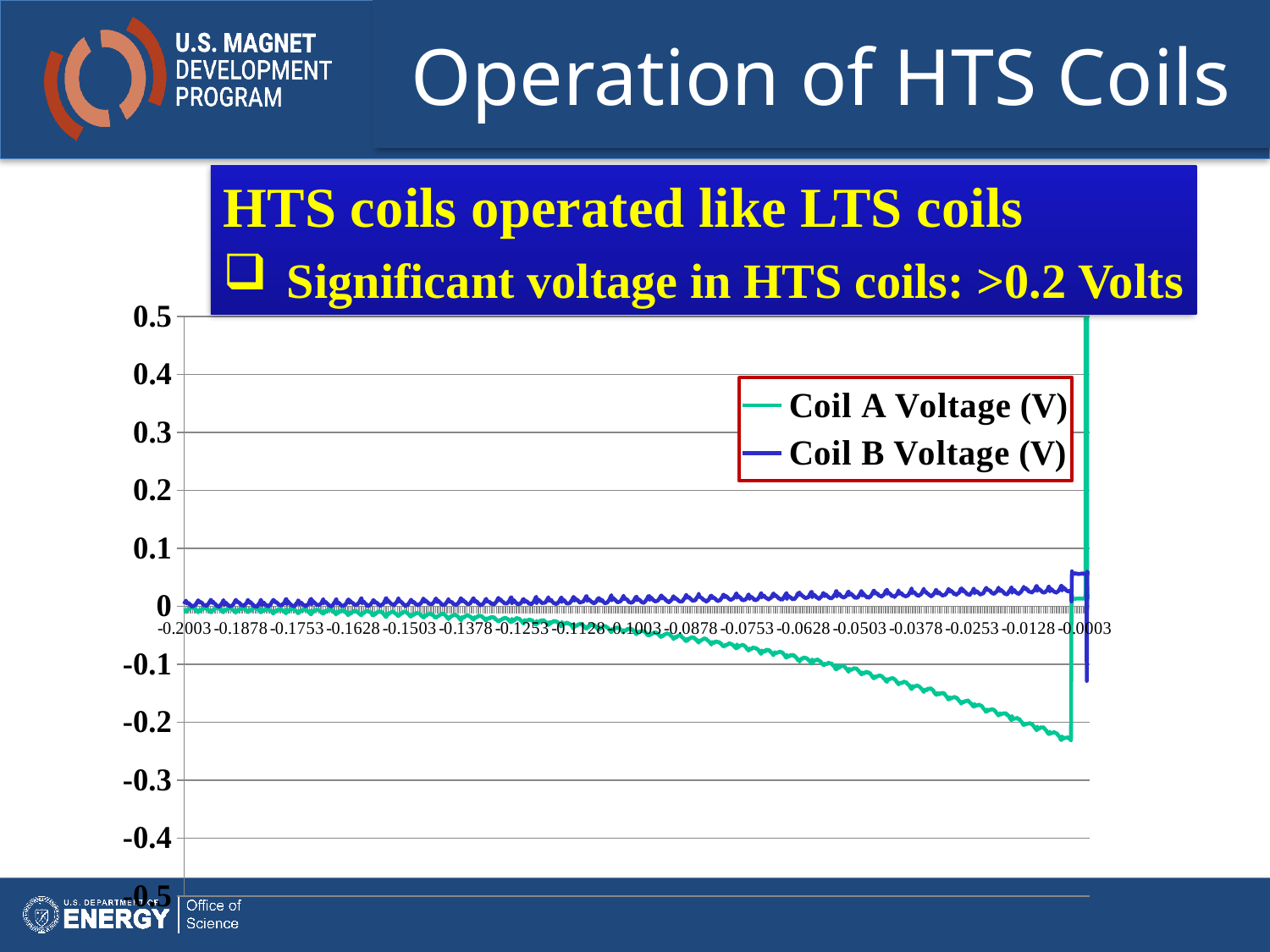
How many tick labels are printed along the chart's x axis? 17 Is the Coil A Voltage (V) value at x = -0.1878 greater or less than 0.1? less Is the Coil A Voltage (V) value at x = -0.0253 greater or less than -0.1? less Does the Coil A Voltage (V) line rise or fall as it moves from left to right along the x axis (before the final spike)? fall What kind of chart is shown on the slide? line chart What are the two series named in the chart legend? Coil A Voltage (V) and Coil B Voltage (V) What is the highest value labelled on the chart's y axis? 0.5 Is the Coil B Voltage (V) value at x = -0.0253 greater or less than 0.1? less What is the lowest value labelled on the chart's y axis? -0.5 How many series does the chart legend list? 2 What colour is the Coil A Voltage (V) line in the chart? green At x = -0.0503, which series has the higher voltage, Coil A Voltage (V) or Coil B Voltage (V)? Coil B Voltage (V)